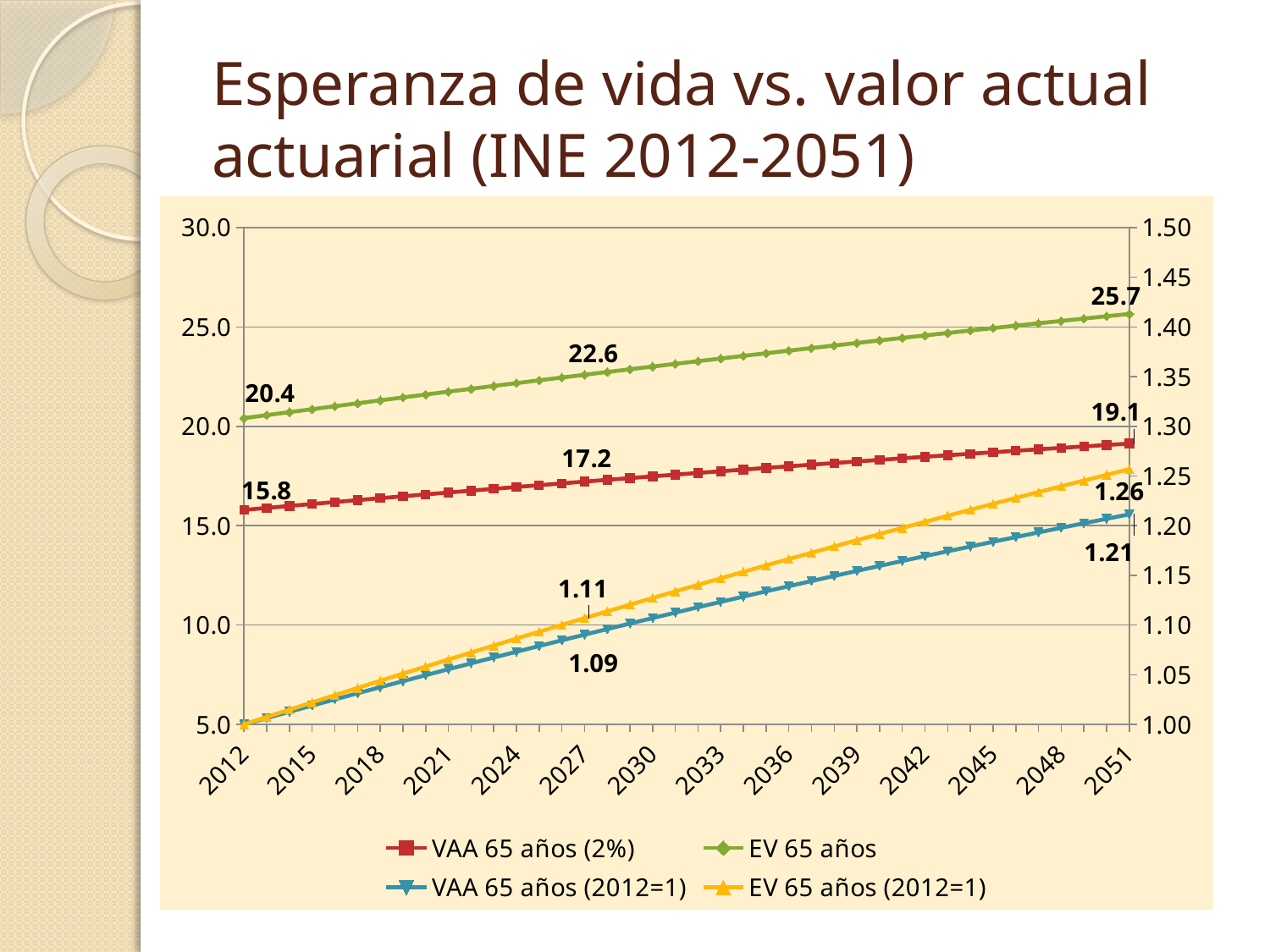
What is the title of the slide containing the chart? Esperanza de vida vs. valor actual actuarial (INE 2012-2051) What is the value of EV 65 años (2012=1) in 2051? 1.26 What is the value of EV 65 años in 2051? 25.7 What kind of chart is shown on the slide? line chart What is the value of VAA 65 años (2%) in 2051? 19.1 What is the difference between EV 65 años (2012=1) and VAA 65 años (2012=1) in 2051? 0.05 How many series does the legend list? 4 What is the value of VAA 65 años (2%) in 2012? 15.8 By how much does EV 65 años increase from 2012 to 2051? 5.3 Do the values of VAA 65 años (2%) rise or fall from 2012 to 2051? rise What is the value of EV 65 años in 2012? 20.4 What is the value of VAA 65 años (2012=1) in 2051? 1.21